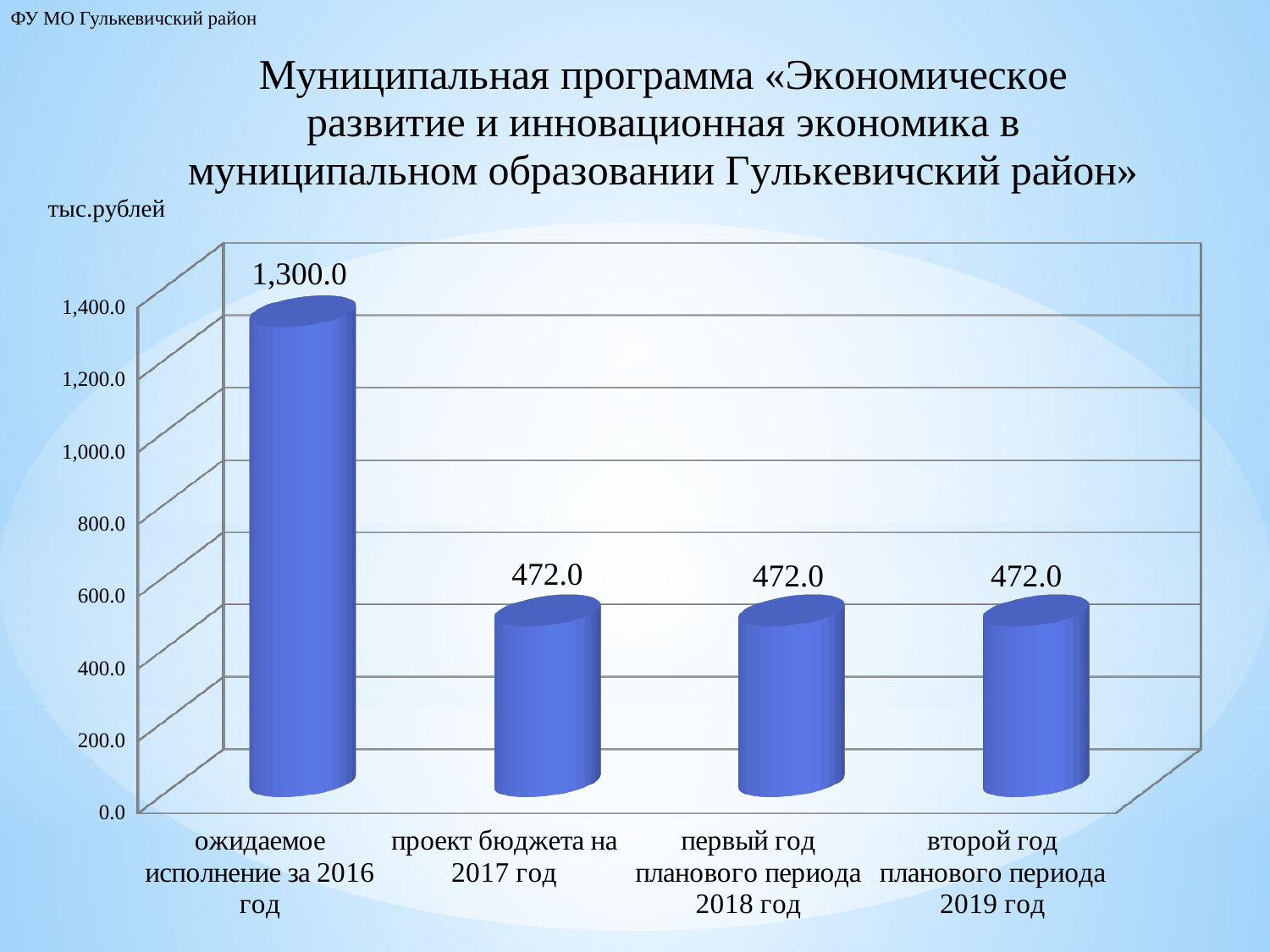
How many categories are shown on the chart? 4 What is the difference between the value for «ожидаемое исполнение за 2016 год» and the value for «проект бюджета на 2017 год»? 828.0 Is the value for «проект бюджета на 2017 год» greater or less than 600.0? less What is the value for «ожидаемое исполнение за 2016 год»? 1,300.0 What is the value for «первый год планового периода 2018 год»? 472.0 Is the value for «ожидаемое исполнение за 2016 год» greater or less than 1,200.0? greater What kind of chart is shown on the slide? bar chart Which category has the highest value? ожидаемое исполнение за 2016 год Which is larger: the value for «ожидаемое исполнение за 2016 год» or the value for «второй год планового периода 2019 год»? ожидаемое исполнение за 2016 год What is the value for «второй год планового периода 2019 год»? 472.0 What unit is indicated above the chart's vertical axis? тыс.рублей What is the value for «проект бюджета на 2017 год»? 472.0